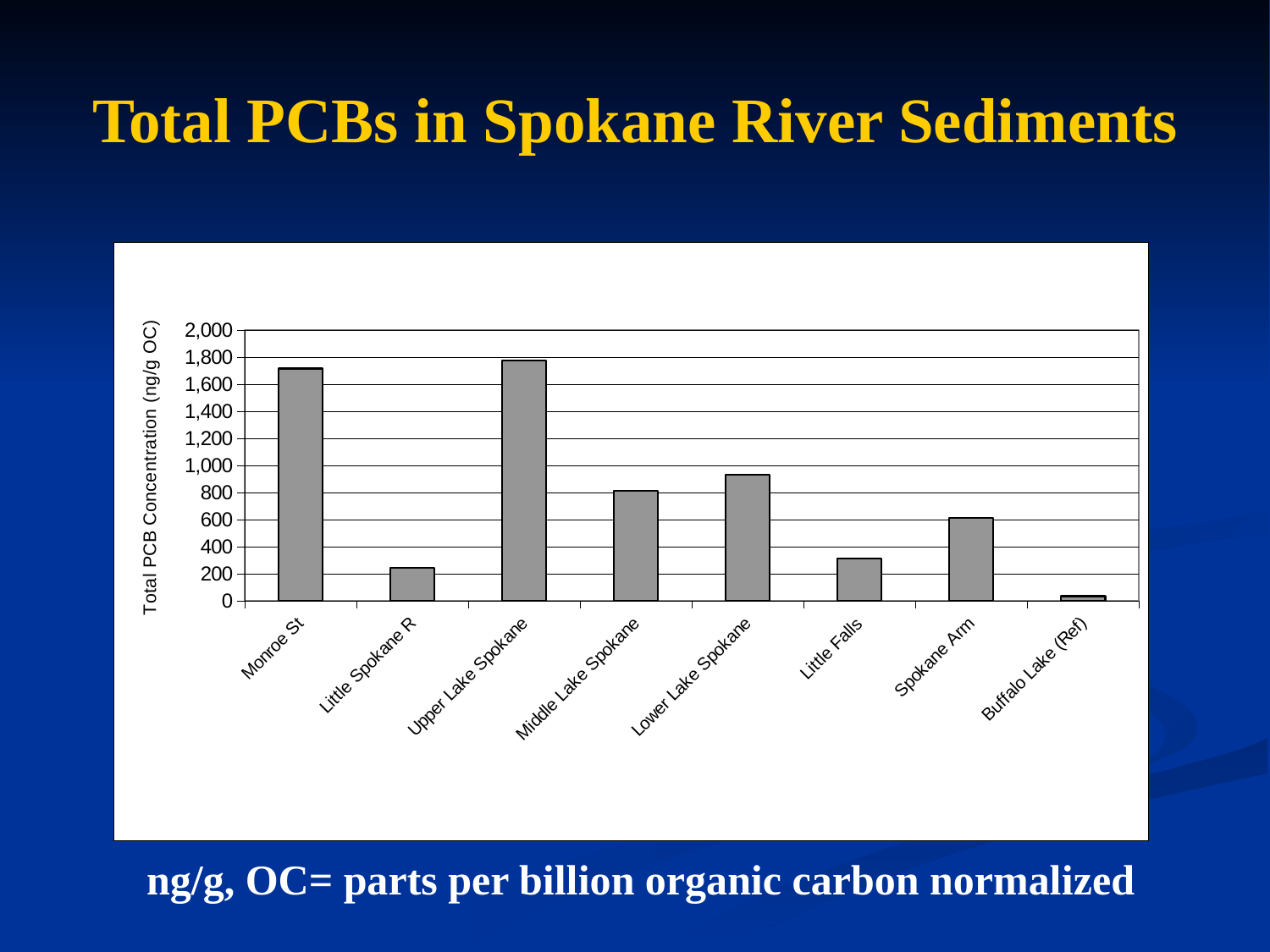
What is the title of the slide containing the chart? Total PCBs in Spokane River Sediments How many sampling sites (categories) are shown on the x axis? 8 Is the value for Middle Lake Spokane greater or less than 1,000? less Which site has the lowest total PCB concentration? Buffalo Lake (Ref) What is the label on the y axis of the chart? Total PCB Concentration (ng/g OC) Is the value for Buffalo Lake (Ref) greater or less than 200? less Which has a higher total PCB concentration, Lower Lake Spokane or Middle Lake Spokane? Lower Lake Spokane Which has a higher total PCB concentration, Spokane Arm or Little Falls? Spokane Arm Is the value for Lower Lake Spokane greater or less than 800? greater What kind of chart is shown on the slide? bar chart